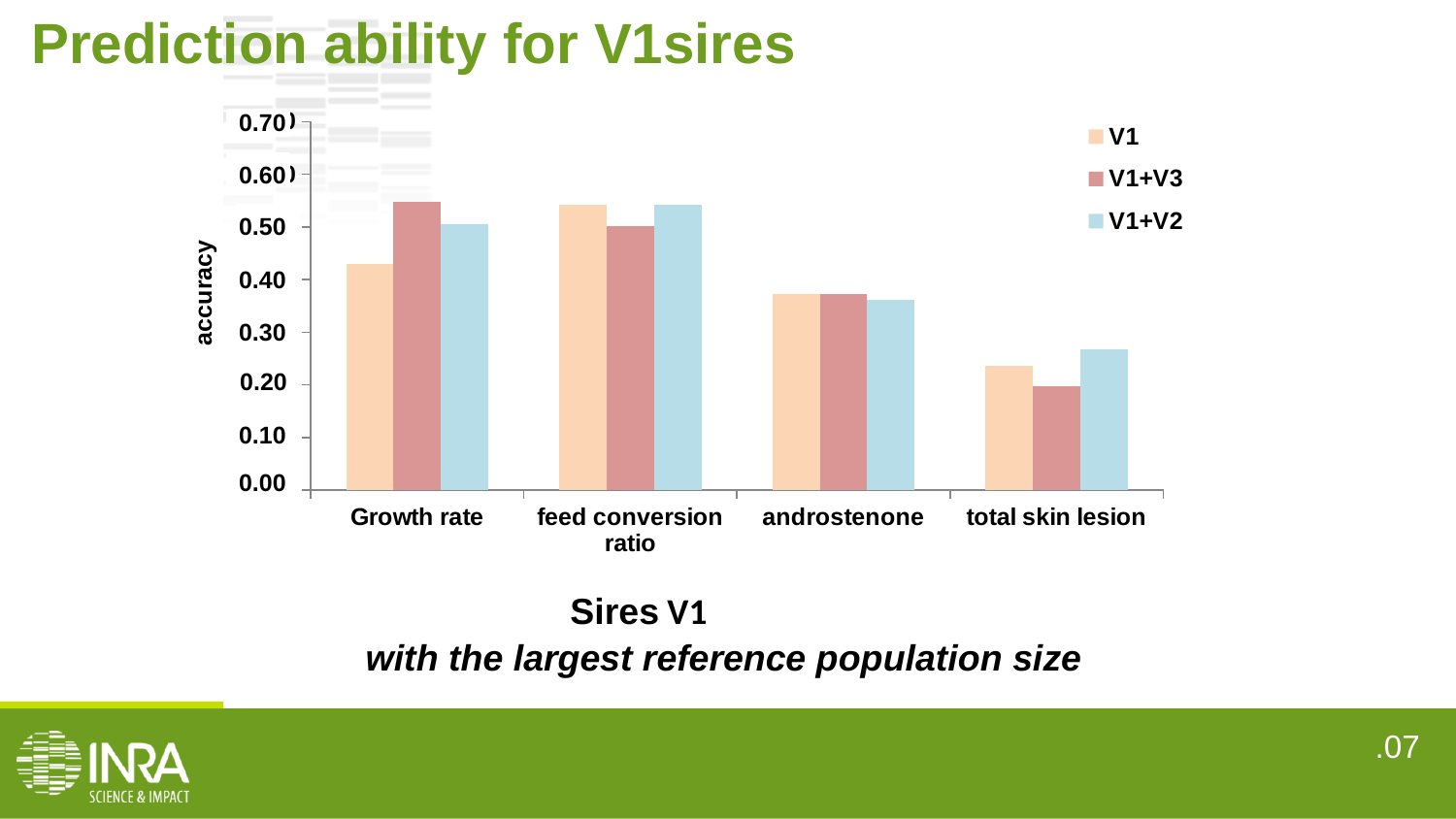
How many series does the chart's legend list? 3 What is the label on the y axis of the chart? accuracy How many categories are shown on the x axis of the chart? 4 For total skin lesion, which is larger: the V1+V2 value or the V1+V3 value? V1+V2 What kind of chart is shown on the slide? bar chart Is the V1+V3 value for Growth rate greater or less than 0.50? greater Is the V1+V3 value for total skin lesion greater or less than 0.30? less Is the V1 value for androstenone greater or less than 0.40? less Which category has the highest V1 value? feed conversion ratio For Growth rate, which is larger: the V1 value or the V1+V3 value? V1+V3 Which category has the lowest V1 value? total skin lesion